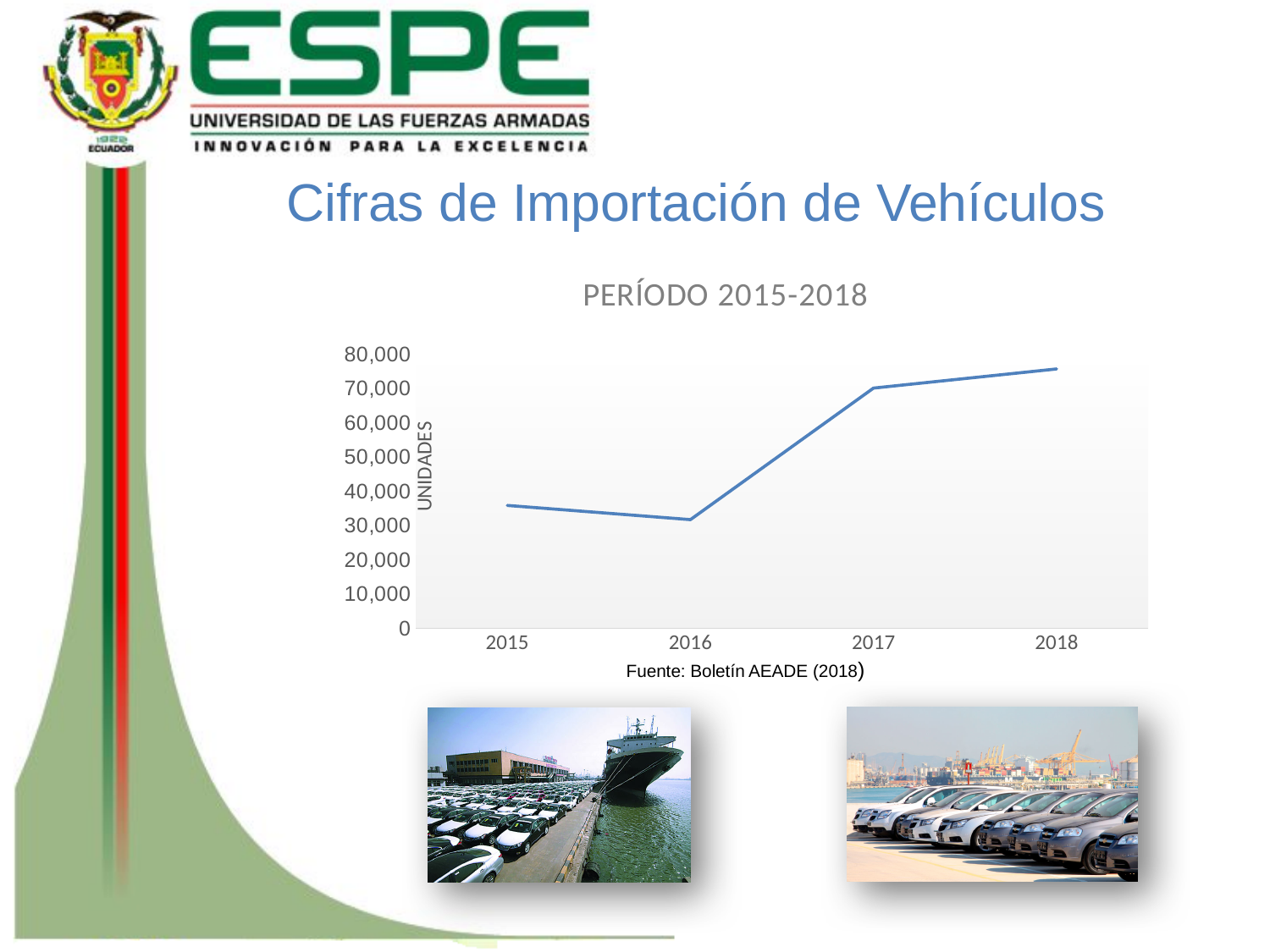
Is the value for 2015 greater or less than 30,000? greater Do the values rise or fall from 2016 to 2018? rise How many years are plotted on the x axis of the chart? 4 Which year has the highest value in the chart? 2018 Is the value for 2018 greater or less than 80,000? less What is the title of the chart? PERÍODO 2015-2018 Is the value for 2017 greater or less than 60,000? greater What kind of chart is shown on the slide? line chart Which year has the larger value, 2015 or 2017? 2017 What is the label of the vertical axis of the chart? UNIDADES Which year has the lowest value in the chart? 2016